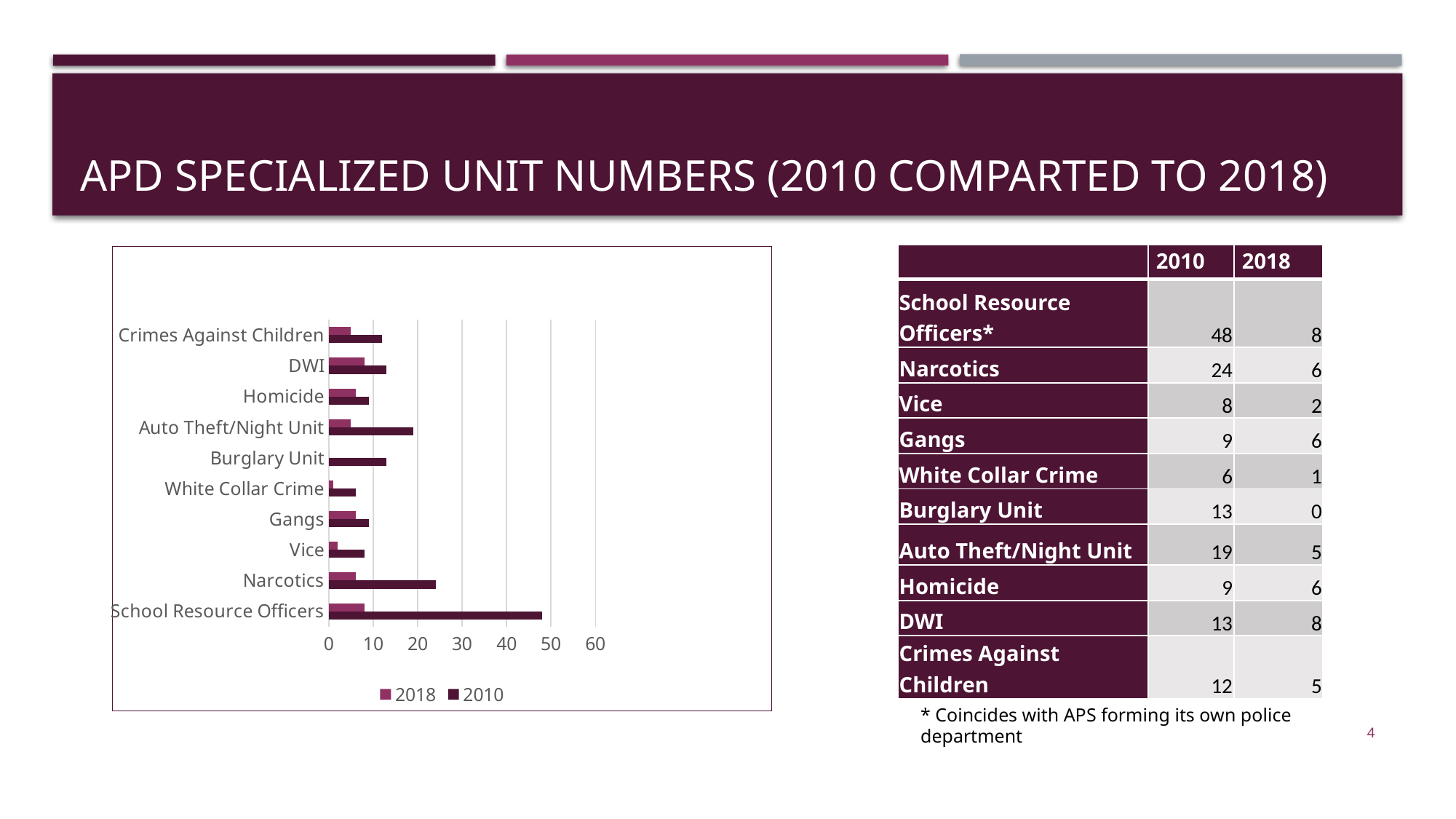
What is the 2010 value for Narcotics? 24 What is the difference between the 2010 and 2018 values for School Resource Officers? 40 Which category has the lowest 2018 value? Burglary Unit Which series is shown in the darker colour in the chart legend? 2010 What is the 2018 value for DWI? 8 Is the 2010 value for Narcotics greater or less than 30? less Which category has the highest 2010 value? School Resource Officers What kind of chart is shown on the slide? bar chart How many categories are plotted on the chart? 10 Which is larger, the 2010 value for Auto Theft/Night Unit or the 2010 value for Gangs? Auto Theft/Night Unit How many series does the chart legend list? 2 Is the 2010 value for School Resource Officers greater or less than 40? greater